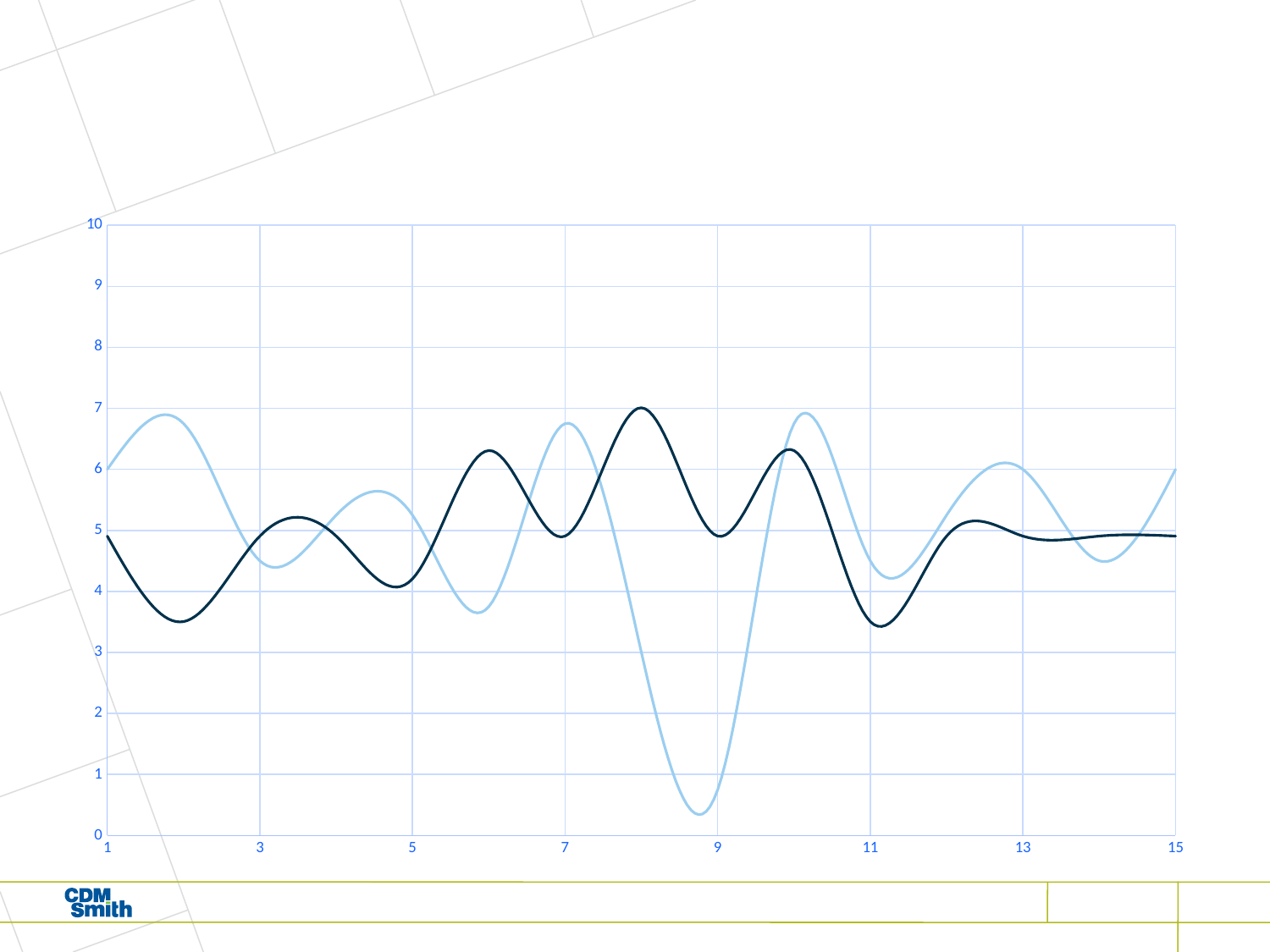
Is the value of the light blue line at x = 6 greater or less than 4? less How many lines are plotted on the chart? 2 At x = 2, which line has the higher value, the dark blue line or the light blue line? light blue line Is the value of the dark blue line at x = 2 greater or less than 4? less Which line reaches the lowest value anywhere on the chart? light blue line Is the value of the dark blue line at x = 11 greater or less than 4? less What kind of chart is shown on the slide? line chart What is the highest value labelled on the y axis? 10 At x = 8, which line has the higher value, the dark blue line or the light blue line? dark blue line